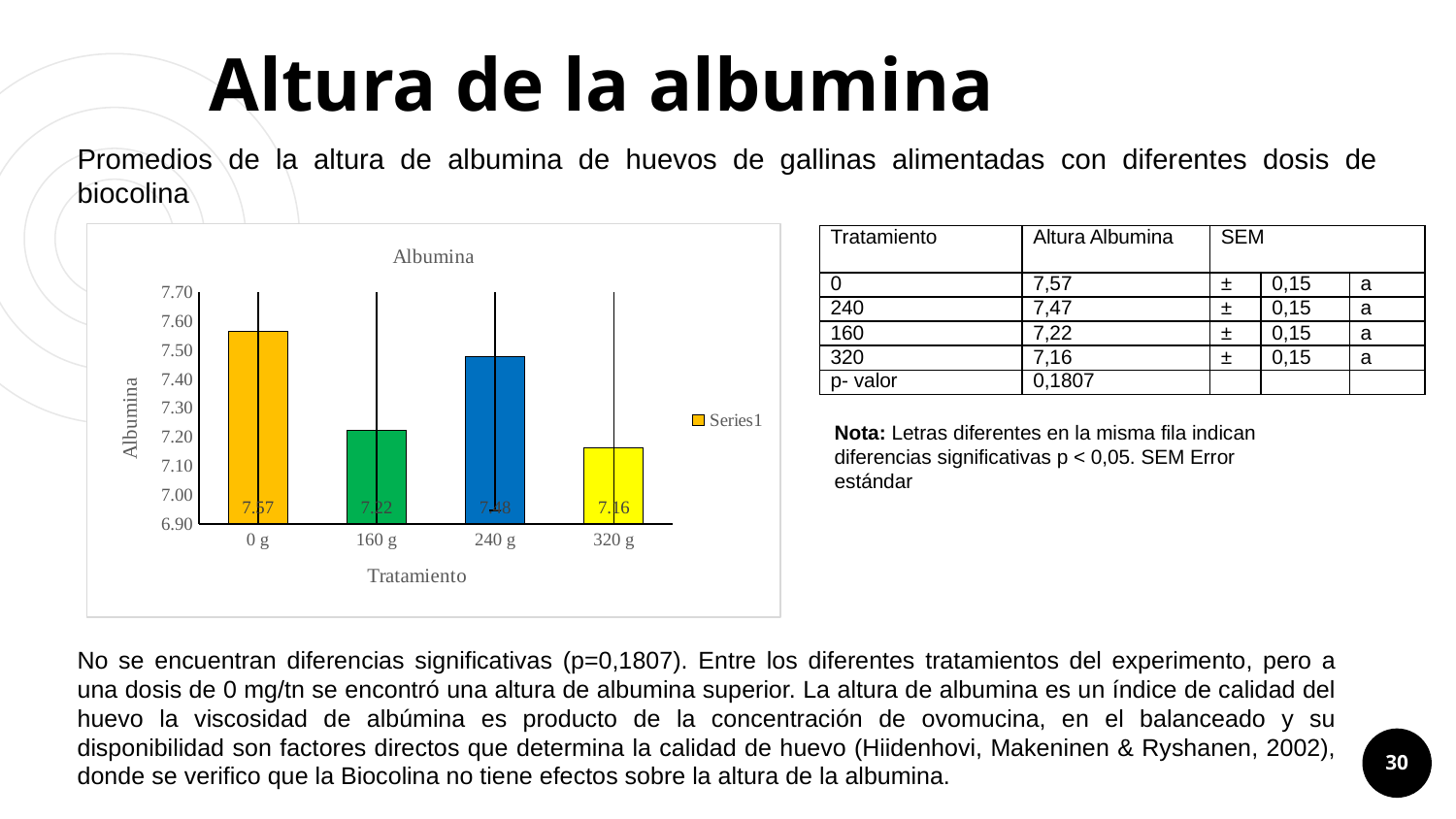
How many series does the chart legend list? 1 What type of chart is shown on the slide? bar chart What is the value for the 160 g treatment in the chart? 7.22 What is the title of the chart? Albumina How many treatment categories are shown on the x axis of the chart? 4 What is the value for the 240 g treatment in the chart? 7.48 Which treatment has the lowest albumina value in the chart? 320 g What is the difference between the values for 0 g and 320 g in the chart? 0.41 What is the value for the 0 g treatment in the chart? 7.57 Which treatment has the highest albumina value in the chart? 0 g Which is larger in the chart, the value for 160 g or the value for 240 g? 240 g What is the value for the 320 g treatment in the chart? 7.16